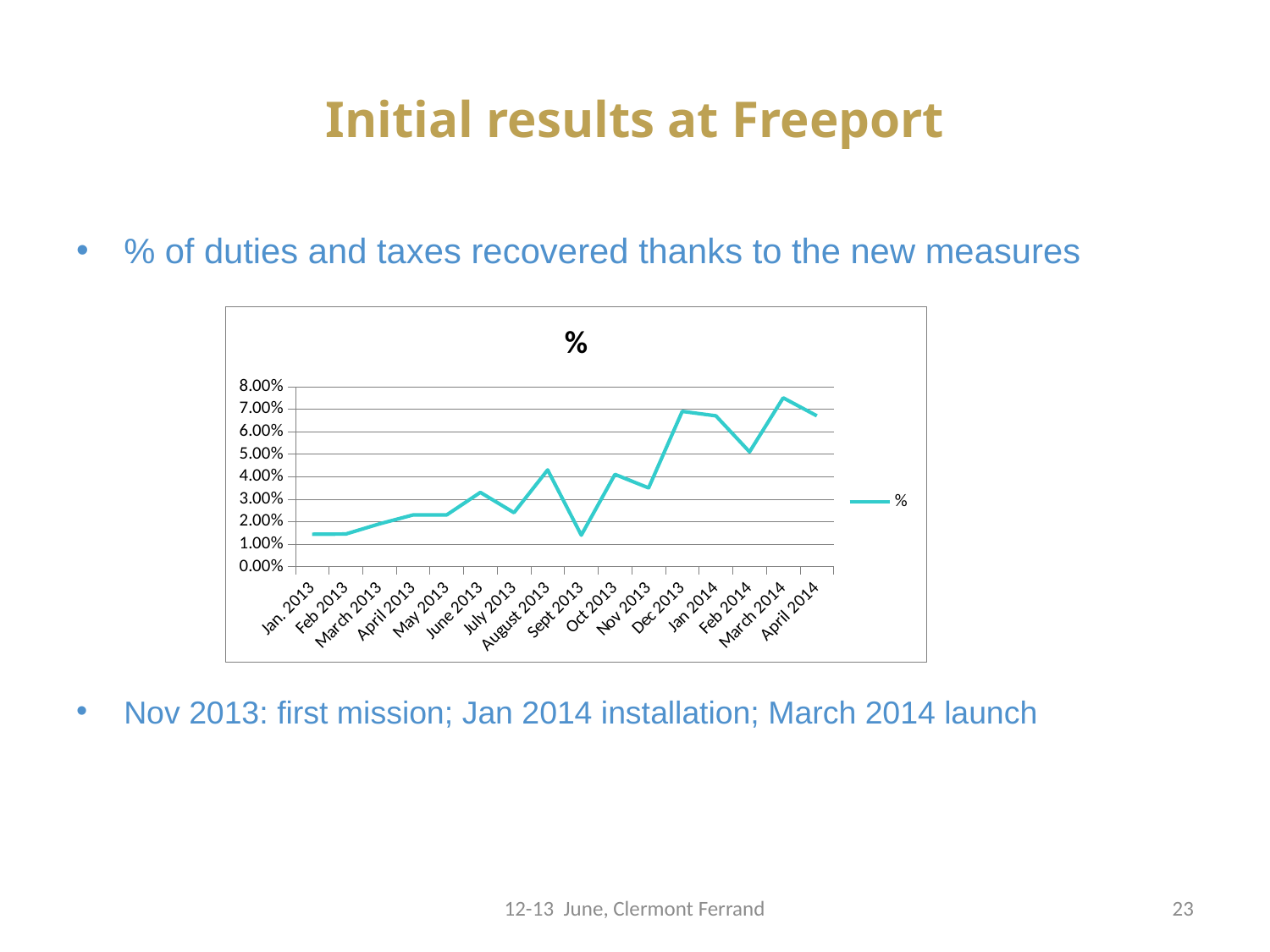
Is the value for Dec 2013 greater or less than 6.00%? greater What kind of chart is shown on the slide? line chart Overall, do the values rise or fall from Jan. 2013 to April 2014? rise Which month has the highest value on the chart? March 2014 How many series does the chart legend list? 1 Is the value for Sept 2013 greater or less than 2.00%? less What is the title of the chart? % Is the value for Jan. 2013 greater or less than 2.00%? less Which is larger, the value for June 2013 or the value for July 2013? June 2013 How many months are plotted along the x axis of the chart? 16 Which is larger, the value for Dec 2013 or the value for Sept 2013? Dec 2013